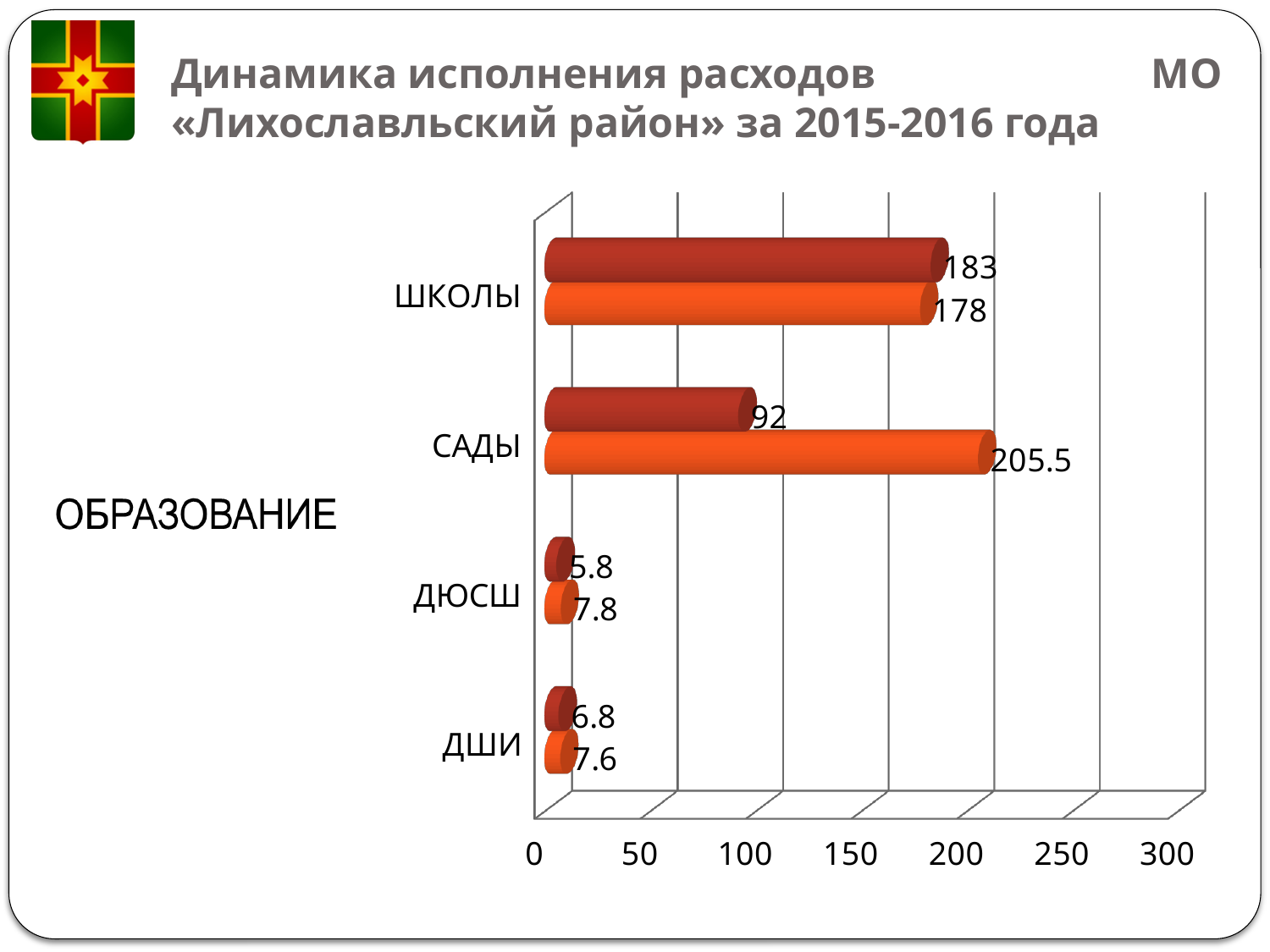
What label is shown to the left of the chart? ОБРАЗОВАНИЕ How many categories are shown on the chart? 4 What type of chart is shown on the slide? bar chart Which category has the lowest value among the dark red (upper) bars? ДЮСШ Which is larger for ШКОЛЫ: the dark red (upper) bar or the orange (lower) bar? the dark red (upper) bar What is the value of the dark red (upper) bar for ДЮСШ? 5.8 What is the value of the orange (lower) bar for ШКОЛЫ? 178 What is the value of the dark red (upper) bar for ШКОЛЫ? 183 What is the value of the orange (lower) bar for ДШИ? 7.6 What is the difference between the orange bar and the dark red bar for САДЫ? 113.5 What is the value of the orange (lower) bar for САДЫ? 205.5 Which category has the highest value among the orange (lower) bars? САДЫ